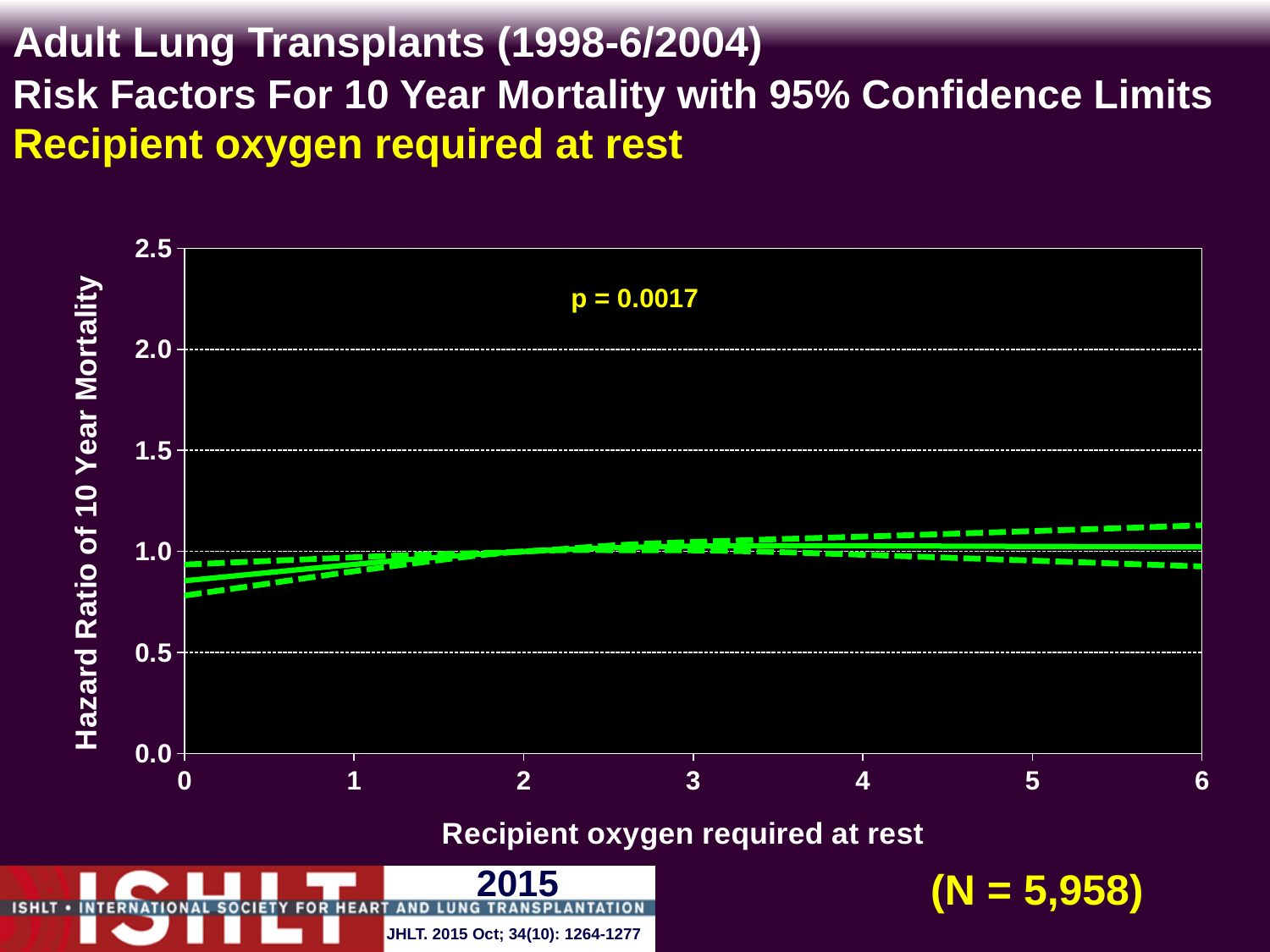
Is the upper 95% confidence limit at a recipient oxygen value of 6 greater or less than 1.0? greater Is the hazard ratio (solid line) at a recipient oxygen value of 0 greater or less than 0.5? greater Does the hazard ratio (solid line) rise or fall as recipient oxygen required at rest increases from 0 to 6? rise What p-value is printed on the chart? p = 0.0017 Is the lower 95% confidence limit at a recipient oxygen value of 0 greater or less than 1.0? less How many lines are plotted on the chart (the hazard ratio and its confidence limits)? 3 What kind of chart is shown on the slide? line chart What is the highest value shown on the y axis of the chart? 2.5